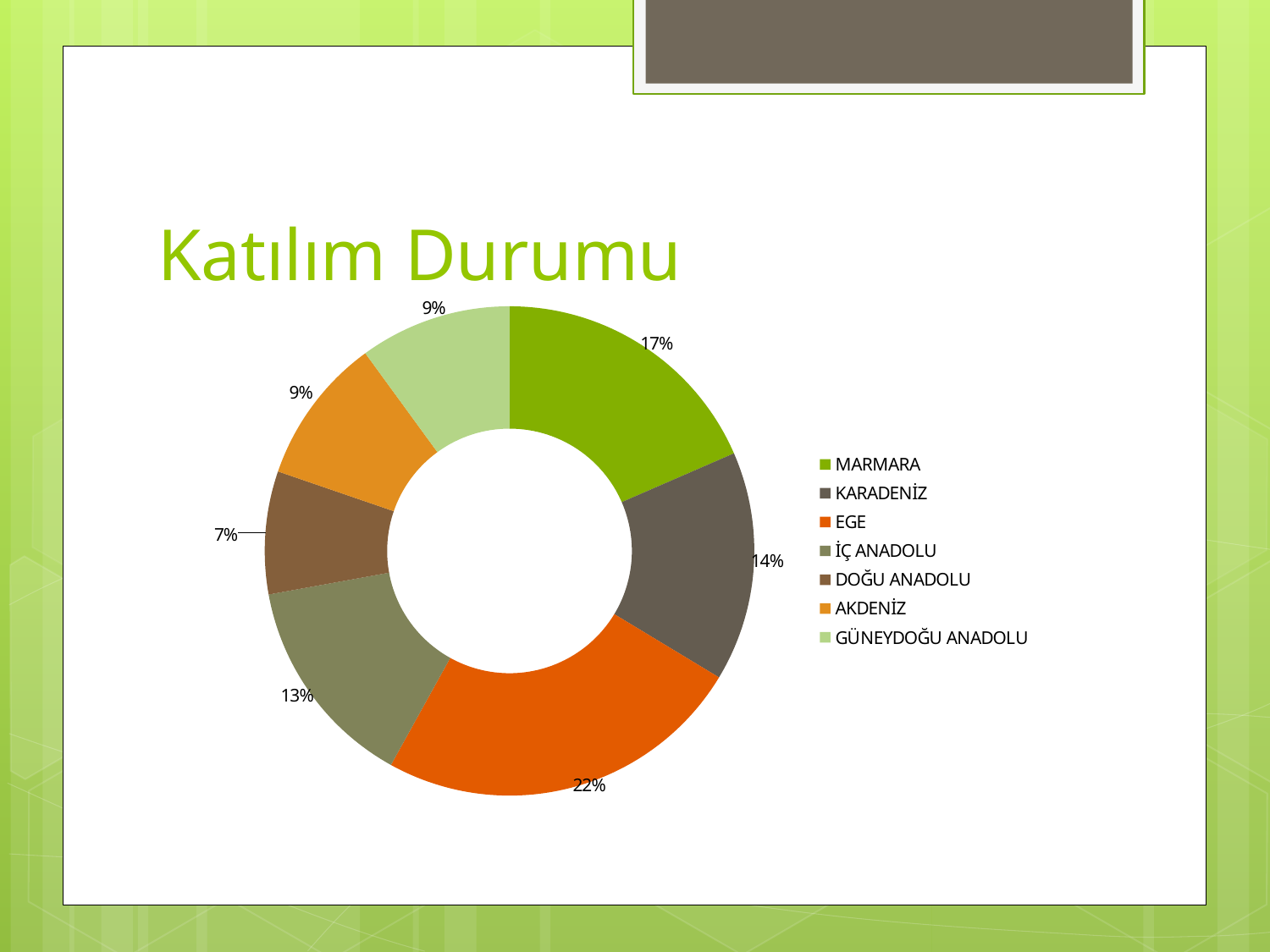
What is the title of the slide containing the chart? Katılım Durumu What share does MARMARA have in the chart? 17% Which region has the largest share in the chart? EGE What share does İÇ ANADOLU have in the chart? 13% What share does KARADENİZ have in the chart? 14% What share does EGE have in the chart? 22% How many categories does the legend list? 7 What share does DOĞU ANADOLU have in the chart? 7% Which has a larger share, KARADENİZ or İÇ ANADOLU? KARADENİZ What kind of chart is shown on the slide? Doughnut chart What is the difference between the shares of EGE and MARMARA? 5% Which region has the smallest share in the chart? DOĞU ANADOLU